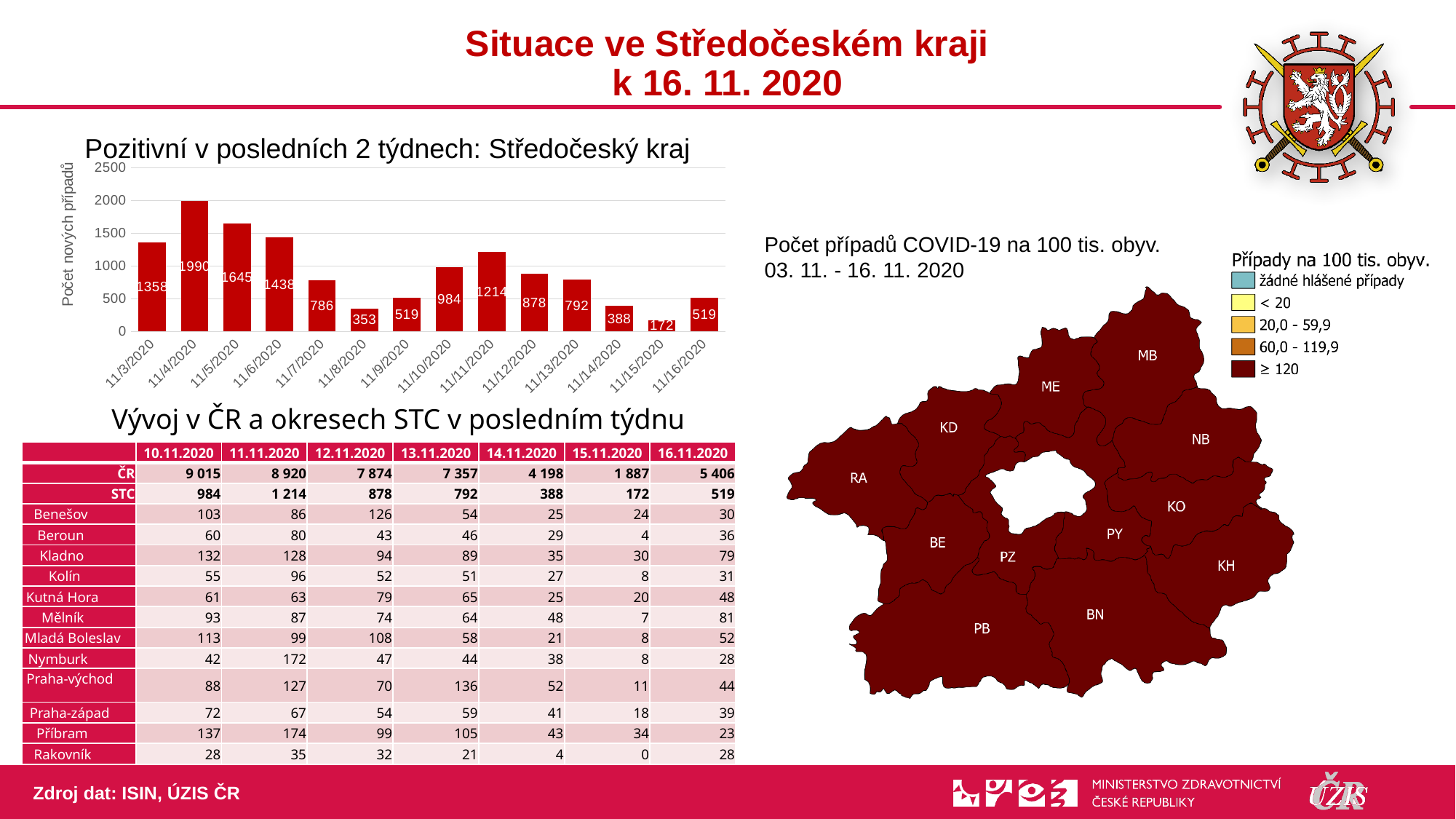
Which date has the highest number of new cases in the bar chart? 11/4/2020 What is the difference between the values for 11/14/2020 and 11/15/2020? 216 How many dates (bars) are shown in the bar chart? 14 Which is larger in the bar chart: the value for 11/10/2020 or 11/11/2020? 11/11/2020 What is the difference between the values for 11/4/2020 and 11/5/2020? 345 What is the value for 11/16/2020 in the bar chart? 519 What is the value for 11/8/2020 in the bar chart? 353 What is the label of the y axis of the bar chart? Počet nových případů Which date has the lowest number of new cases in the bar chart? 11/15/2020 What type of chart is used to show positive cases in the last 2 weeks in Středočeský kraj? bar chart Is the value for 11/3/2020 greater or less than 1000? greater How many new cases does the chart show for 11/4/2020? 1990